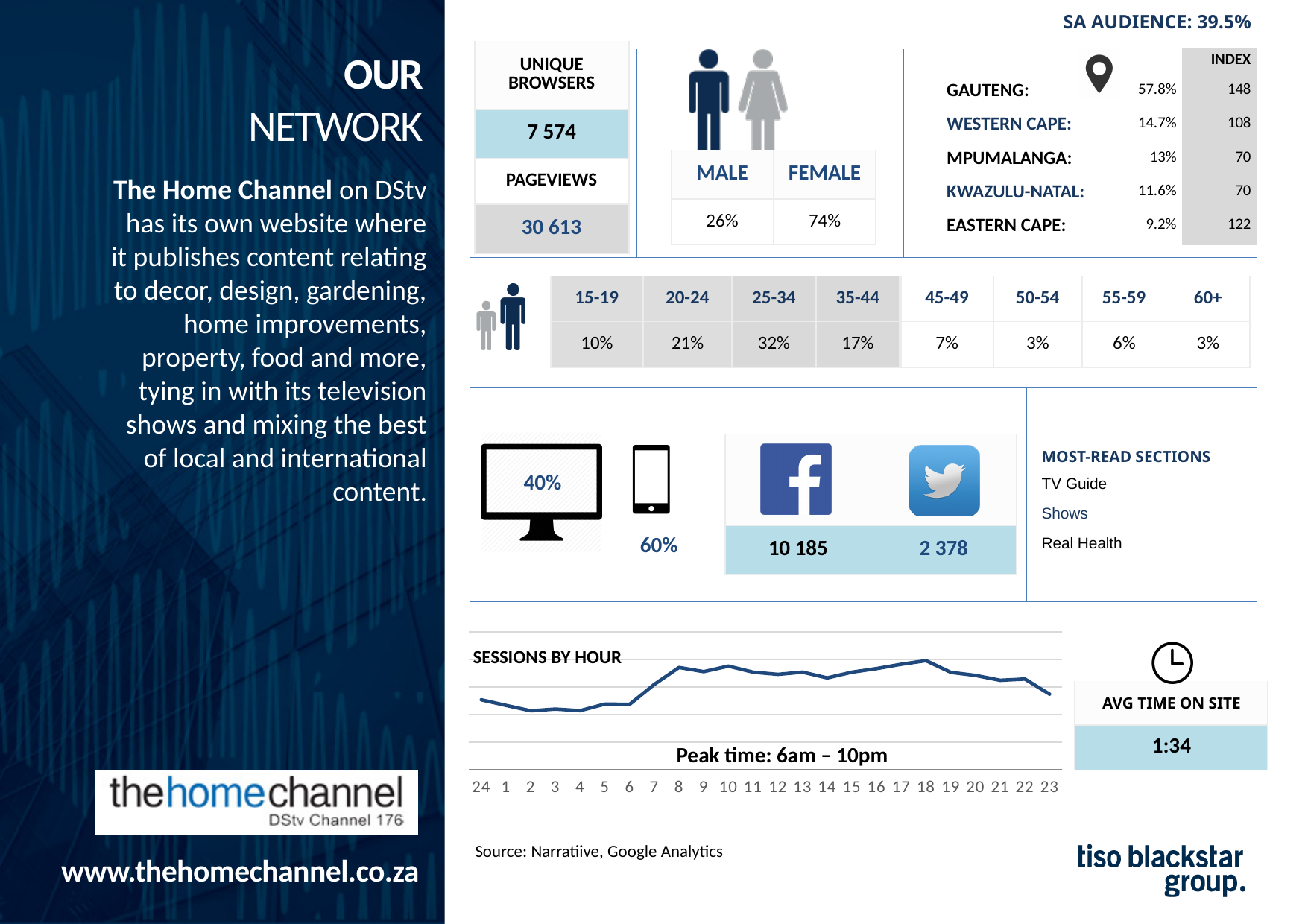
In the 'Sessions by Hour' chart, do sessions rise or fall between hour 6 and hour 8? rise What peak time is stated beneath the 'Sessions by Hour' chart? 6am – 10pm In the 'Sessions by Hour' chart, is the value at hour 8 larger or smaller than the value at hour 2? larger In the 'Sessions by Hour' chart, do sessions rise or fall between hour 18 and hour 23? fall What is the title of the line chart at the bottom of the slide? SESSIONS BY HOUR In the 'Sessions by Hour' chart, at which hour does the line reach its highest point? 18 In the 'Sessions by Hour' chart, which has the larger value: hour 18 or hour 23? 18 How many hour points are plotted along the x axis of the 'Sessions by Hour' chart? 24 In the 'Sessions by Hour' chart, is the value at hour 10 larger or smaller than the value at hour 4? larger What kind of chart is the 'Sessions by Hour' chart? line chart